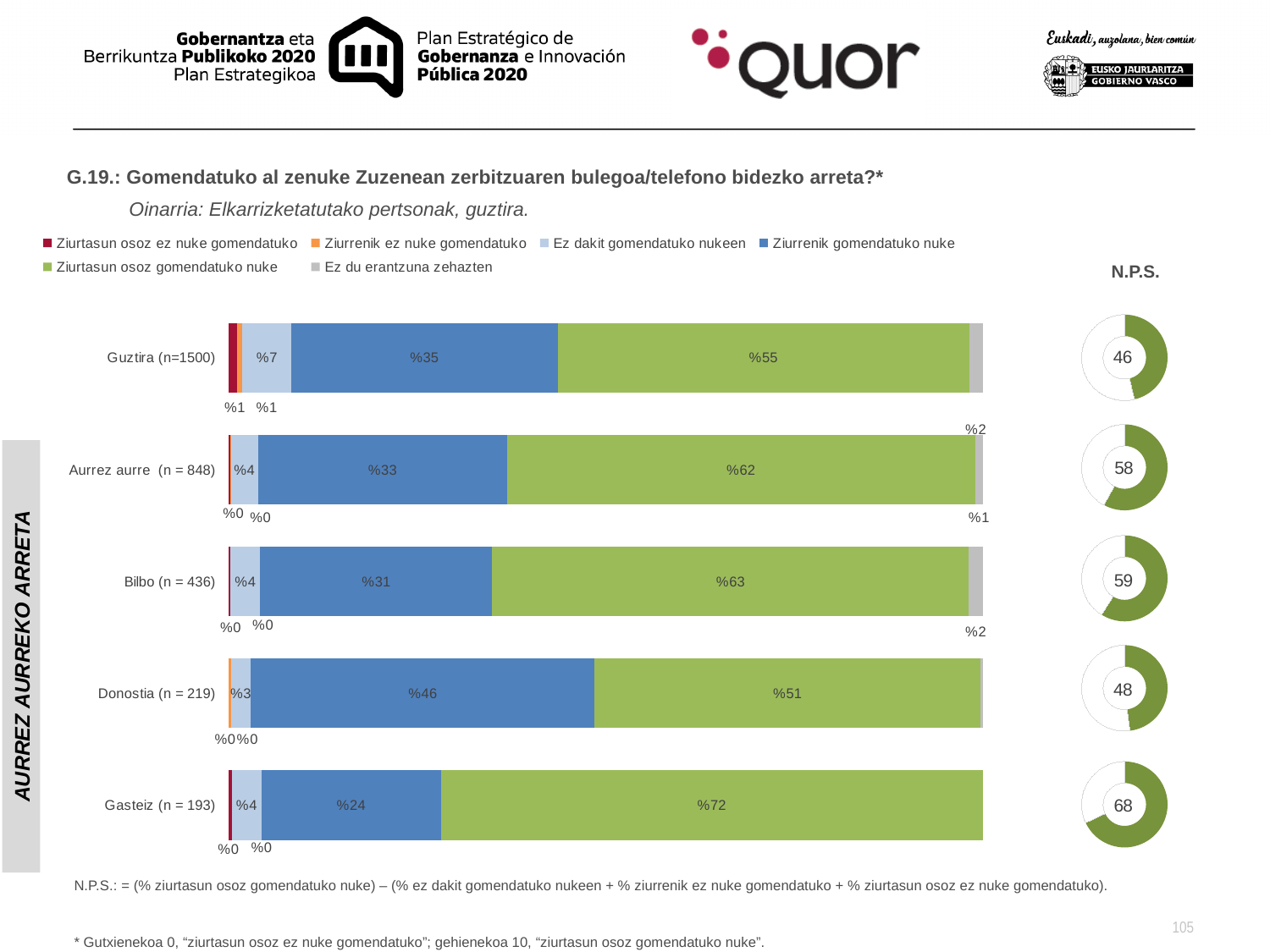
In the stacked bar chart, which category has the lowest value for 'Ziurrenik gomendatuko nuke'? Gasteiz (n = 193) In the stacked bar chart, is the 'Ziurrenik gomendatuko nuke' value larger for Donostia (n = 219) or for Bilbo (n = 436)? Donostia (n = 219) In the stacked bar chart, which category has the highest value for 'Ziurtasun osoz gomendatuko nuke'? Gasteiz (n = 193) In the N.P.S. donut charts on the right, which category has the highest N.P.S. value? Gasteiz (n = 193) In the stacked bar chart, what is the value of 'Ziurtasun osoz gomendatuko nuke' for Gasteiz (n = 193)? %72 In the N.P.S. donut charts on the right, what is the N.P.S. value for Guztira (n=1500)? 46 In the stacked bar chart, what is the value of 'Ziurrenik gomendatuko nuke' for Donostia (n = 219)? %46 How many categories (rows) are shown in the stacked bar chart? 5 In the stacked bar chart, what is the value of 'Ez dakit gomendatuko nukeen' for Guztira (n=1500)? %7 What kind of chart is the main chart on the slide? stacked bar chart How many series does the legend of the stacked bar chart list? 6 In the stacked bar chart, what is the difference between the 'Ziurtasun osoz gomendatuko nuke' values for Bilbo (n = 436) and Aurrez aurre (n = 848)? 1 percentage point